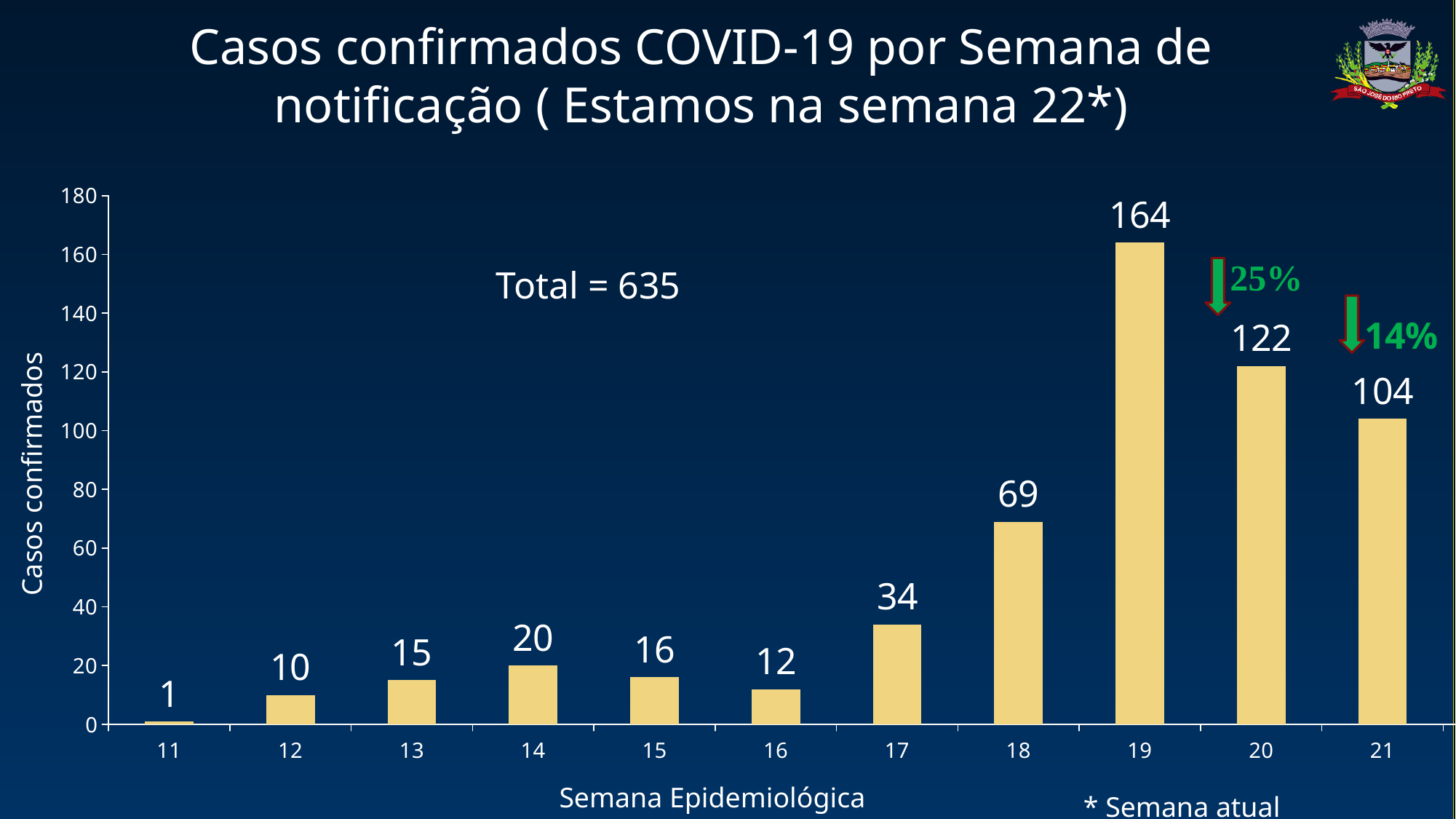
Which epidemiological week has the lowest number of confirmed cases? 11 Which epidemiological week has the highest number of confirmed cases? 19 What is the difference in confirmed cases between week 19 and week 20? 42 How many confirmed cases are shown for epidemiological week 19? 164 What is the difference in confirmed cases between week 18 and week 17? 35 Do the confirmed cases rise or fall from week 19 to week 21? fall What is the label of the y axis? Casos confirmados Which week has more confirmed cases, week 14 or week 15? 14 What total is printed on the chart? Total = 635 What kind of chart is shown on the slide? bar chart How many epidemiological weeks are plotted on the chart? 11 What is the value for week 17? 34